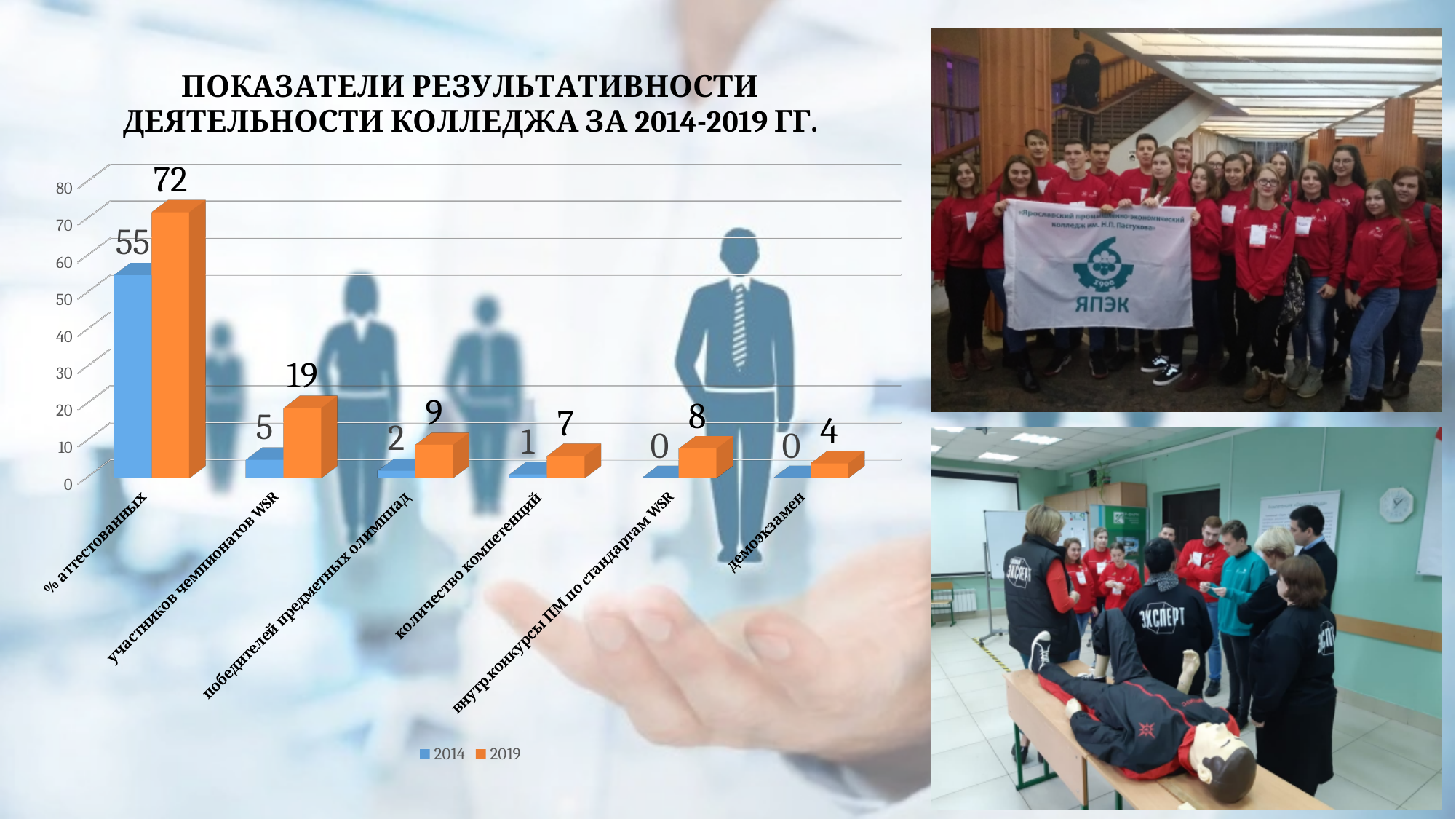
What is the 2019 value for % аттестованных? 72 What is the difference between the 2019 and 2014 values for % аттестованных? 17 Which category has the highest 2019 value? % аттестованных What is the 2019 value for количество компетенций? 7 Which is larger: the 2019 value for победителей предметных олимпиад or the 2019 value for внутр.конкурсы ПМ по стандартам WSR? победителей предметных олимпиад What is the difference between the 2019 and 2014 values for участников чемпионатов WSR? 14 What type of chart is shown on the slide? bar chart What is the 2014 value for демоэкзамен? 0 How many series does the legend list? 2 Which category has the lowest 2019 value? демоэкзамен How many categories are shown on the x axis of the chart? 6 What is the 2014 value for участников чемпионатов WSR? 5